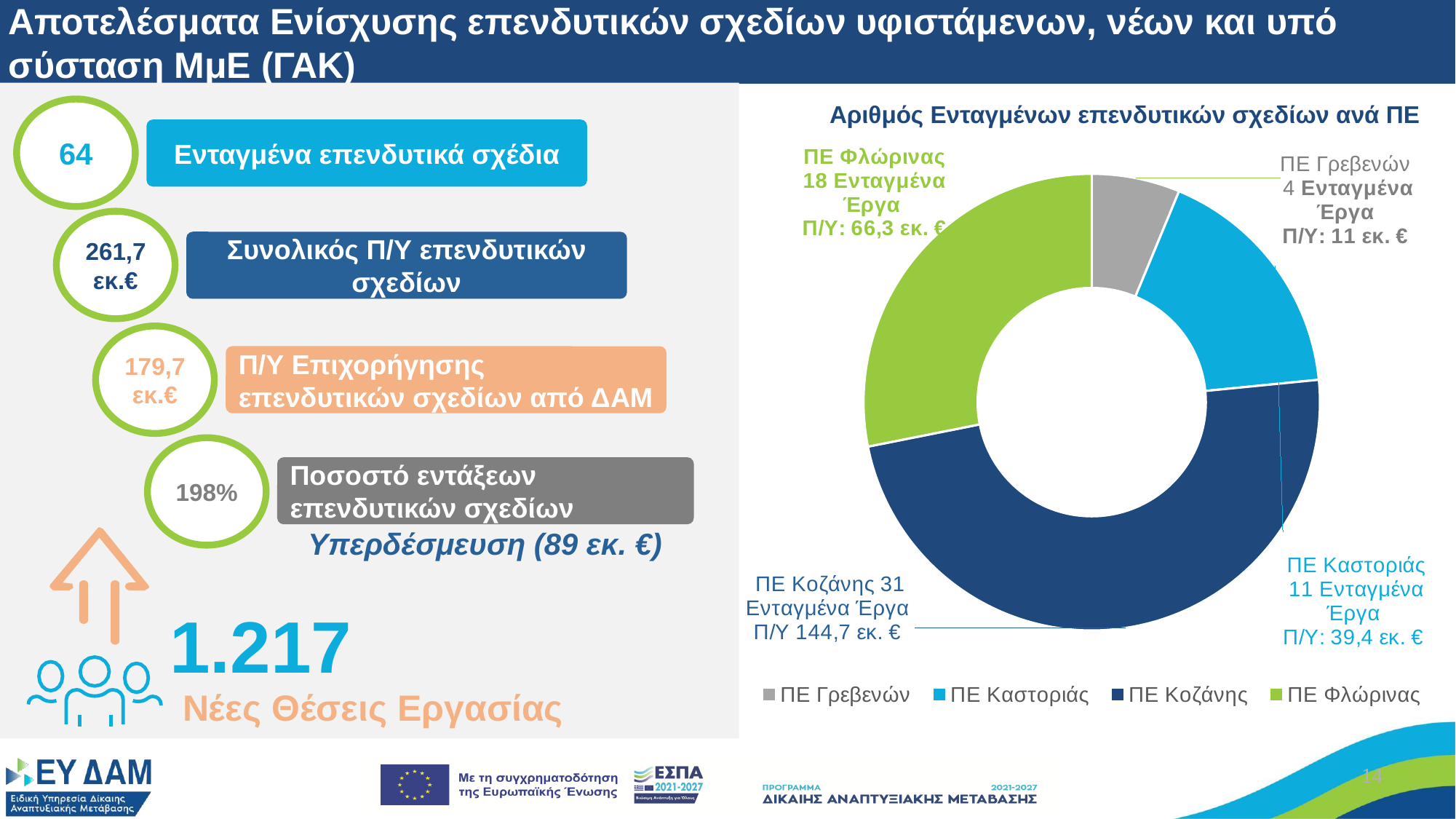
How many ενταγμένα έργα does ΠΕ Γρεβενών have according to the chart? 4 What is the Π/Υ shown for ΠΕ Καστοριάς in the chart? 39,4 εκ. € Which has more ενταγμένα έργα, ΠΕ Καστοριάς or ΠΕ Γρεβενών? ΠΕ Καστοριάς How many ενταγμένα έργα does ΠΕ Κοζάνης have according to the chart? 31 How many more ενταγμένα έργα does ΠΕ Φλώρινας have than ΠΕ Καστοριάς? 7 How many ΠΕ (regional units) are shown in the chart? 4 What type of chart is shown on the slide? Doughnut (pie) chart Which ΠΕ has the lowest number of ενταγμένα έργα in the chart? ΠΕ Γρεβενών Which ΠΕ has the highest number of ενταγμένα έργα in the chart? ΠΕ Κοζάνης What is the title of the chart on the slide? Αριθμός Ενταγμένων επενδυτικών σχεδίων ανά ΠΕ How many entries does the chart legend list? 4 What is the Π/Υ shown for ΠΕ Φλώρινας in the chart? 66,3 εκ. €